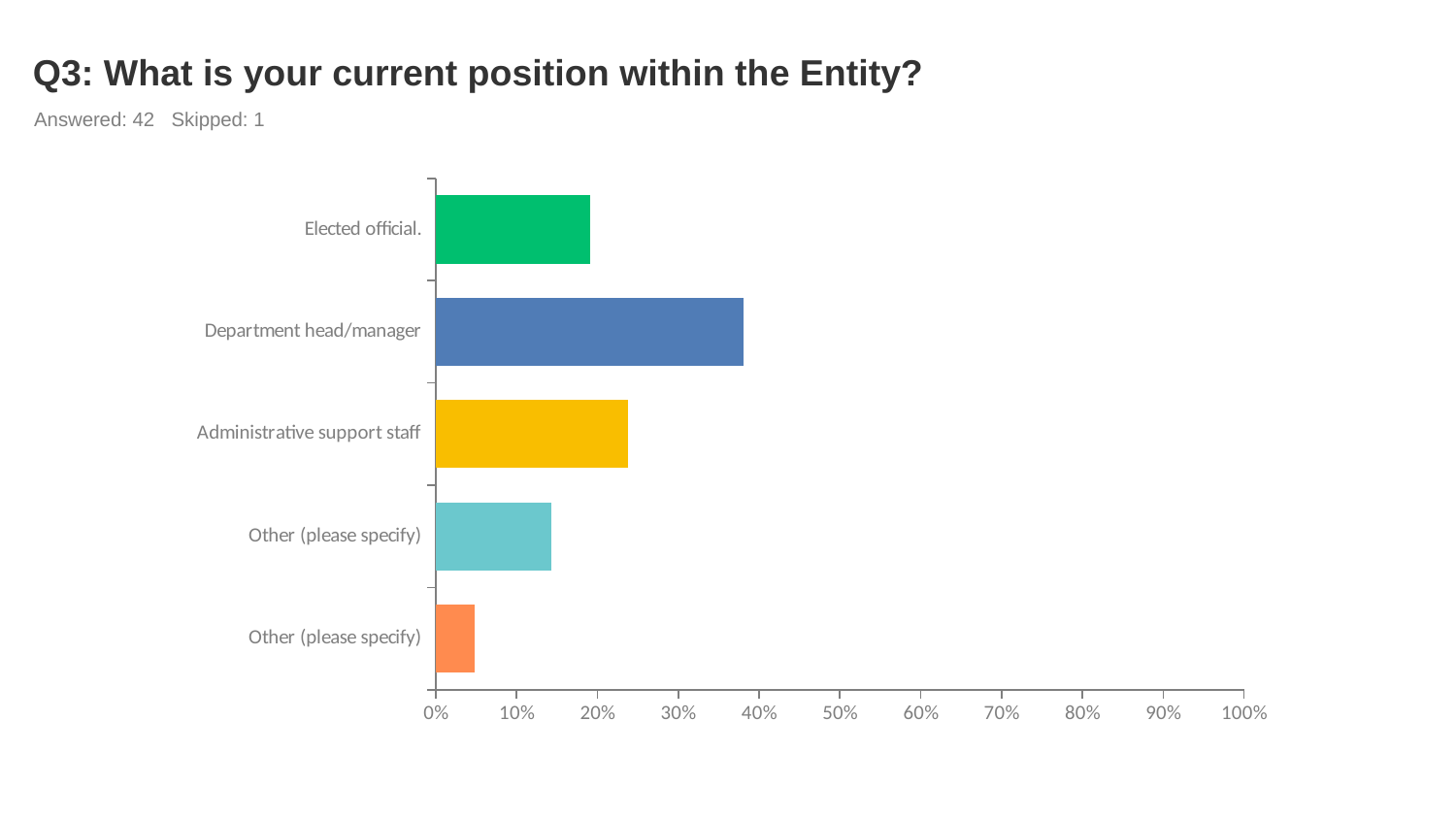
Is the value for Administrative support staff greater or less than 20%? greater Is the value for the bottom bar, Other (please specify), greater or less than 10%? less Which category has the highest value? Department head/manager What kind of chart is shown on the slide? bar chart How many respondents answered the question according to the slide? 42 Which is larger, the value for Department head/manager or the value for Administrative support staff? Department head/manager Is the value for Elected official greater or less than 10%? greater Which is larger, the value for Elected official or the value for Administrative support staff? Administrative support staff What is the title of the chart? Q3: What is your current position within the Entity? Which bar is the shortest in the chart? The bottom bar, Other (please specify) How many categories (bars) does the chart show? 5